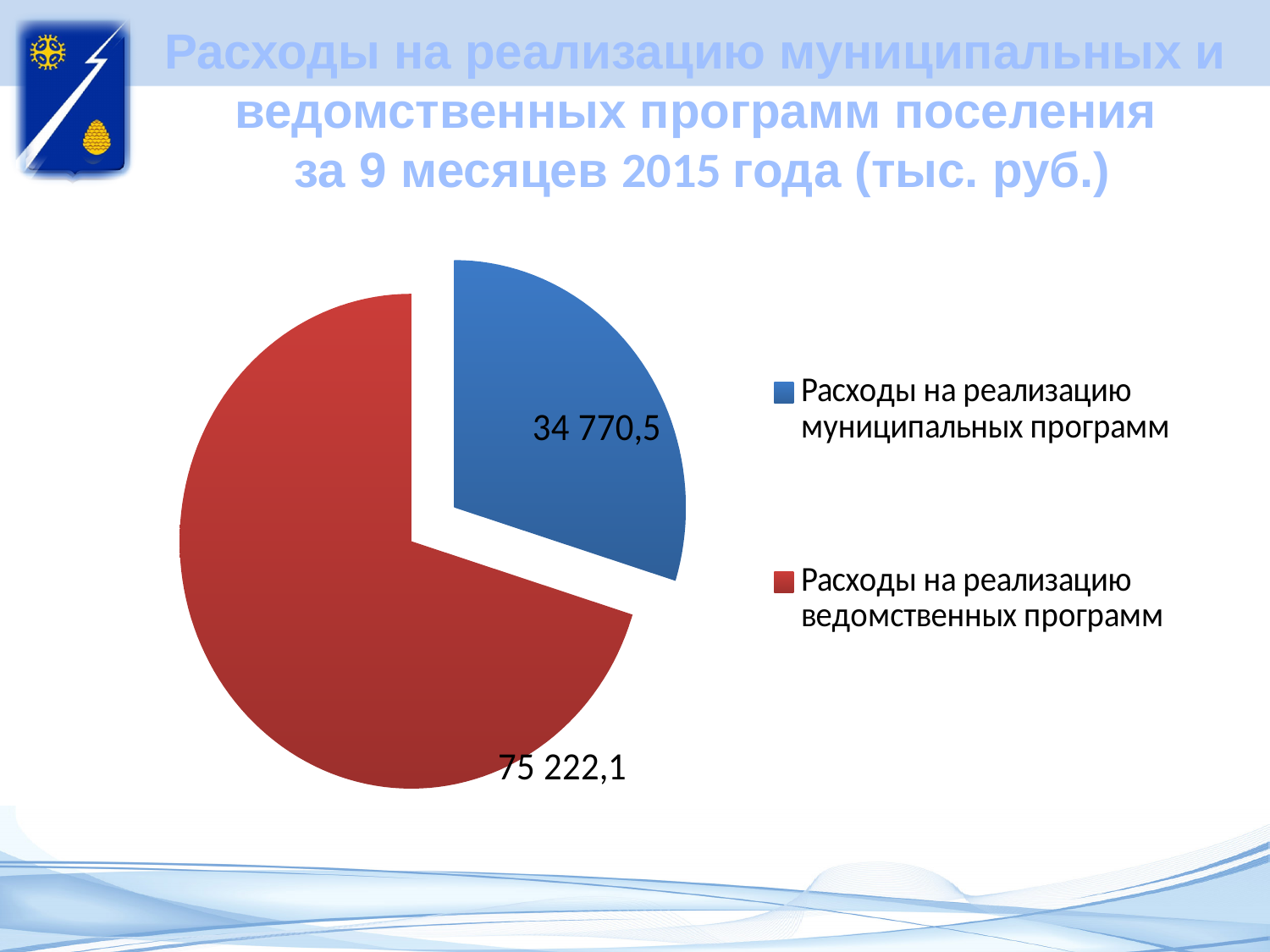
What kind of chart is shown on the slide? Pie chart How many entries does the legend list? 2 Which is larger: the value for муниципальных программ or the value for ведомственных программ? Расходы на реализацию ведомственных программ What value is shown for "Расходы на реализацию ведомственных программ"? 75 222,1 Which category has the largest slice of the pie? Расходы на реализацию ведомственных программ What is the difference between the value for ведомственных программ and the value for муниципальных программ? 40 451,6 What value is shown for "Расходы на реализацию муниципальных программ"? 34 770,5 How many slices does the pie chart have? 2 What is the total of the two values shown in the pie chart? 109 992,6 What colour is the slice for "Расходы на реализацию муниципальных программ"? Blue Which category has the smallest slice of the pie? Расходы на реализацию муниципальных программ